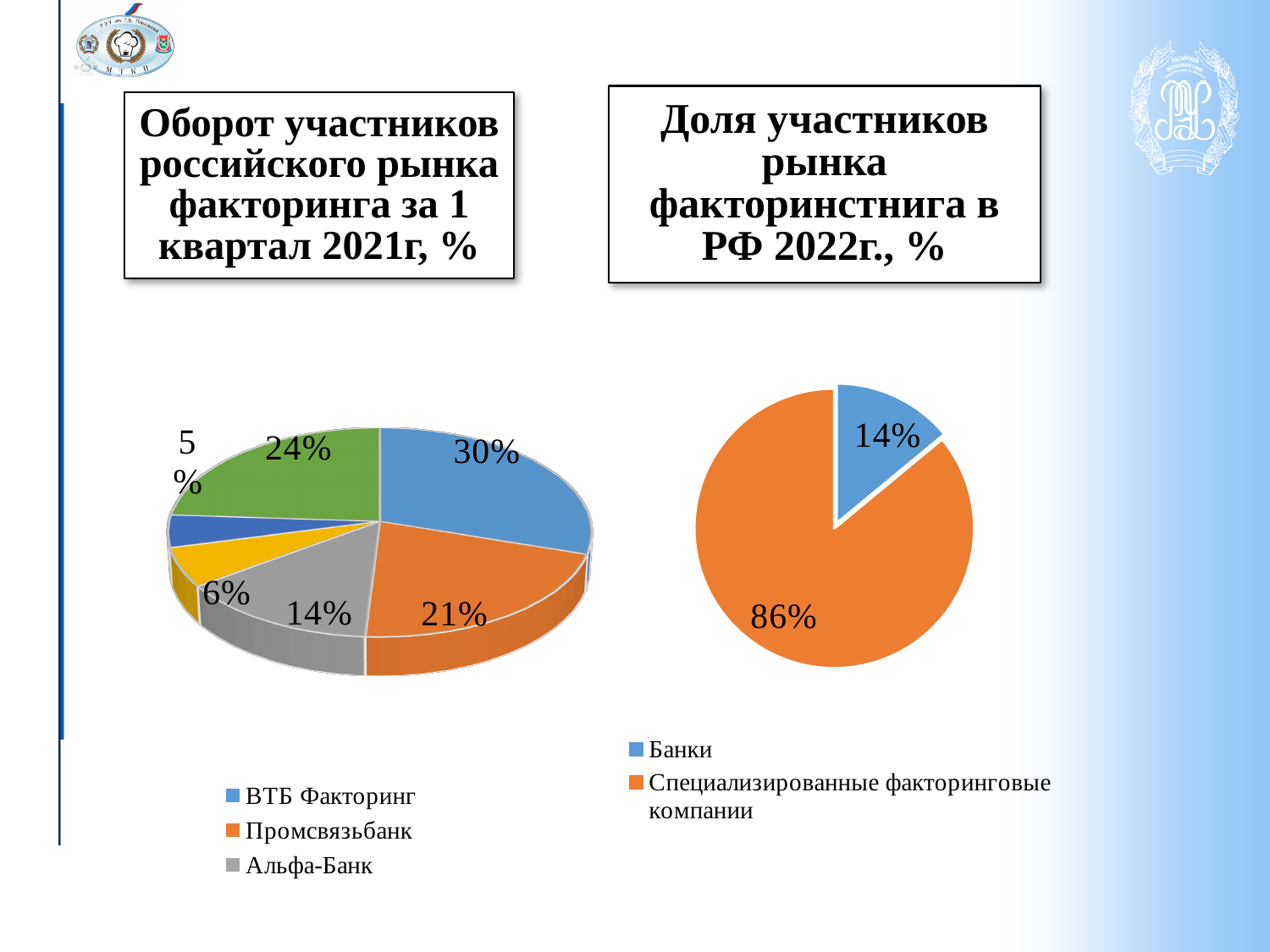
In the left chart (Оборот участников российского рынка факторинга за 1 квартал 2021г, %), what is the value for ВТБ Факторинг? 30% In the left chart (Оборот участников российского рынка факторинга за 1 квартал 2021г, %), which is larger, ВТБ Факторинг or Промсвязьбанк? ВТБ Факторинг In the right chart (Доля участников рынка факторинстнига в РФ 2022г., %), which category has the largest share? Специализированные факторинговые компании In the left chart (Оборот участников российского рынка факторинга за 1 квартал 2021г, %), what is the value for Альфа-Банк? 14% How many entries does the legend of the right chart (Доля участников рынка факторинстнига в РФ 2022г., %) list? 2 In the right chart (Доля участников рынка факторинстнига в РФ 2022г., %), what is the value for Банки? 14% How many slices does the left chart (Оборот участников российского рынка факторинга за 1 квартал 2021г, %) have? 6 In the right chart (Доля участников рынка факторинстнига в РФ 2022г., %), what is the difference between the values for Специализированные факторинговые компании and Банки? 72% In the left chart (Оборот участников российского рынка факторинга за 1 квартал 2021г, %), what is the difference between the values for ВТБ Факторинг and Альфа-Банк? 16% What kind of chart is the left chart (Оборот участников российского рынка факторинга за 1 квартал 2021г, %)? Pie chart In the left chart (Оборот участников российского рынка факторинга за 1 квартал 2021г, %), what is the value for Промсвязьбанк? 21% In the right chart (Доля участников рынка факторинстнига в РФ 2022г., %), what is the value for Специализированные факторинговые компании? 86%